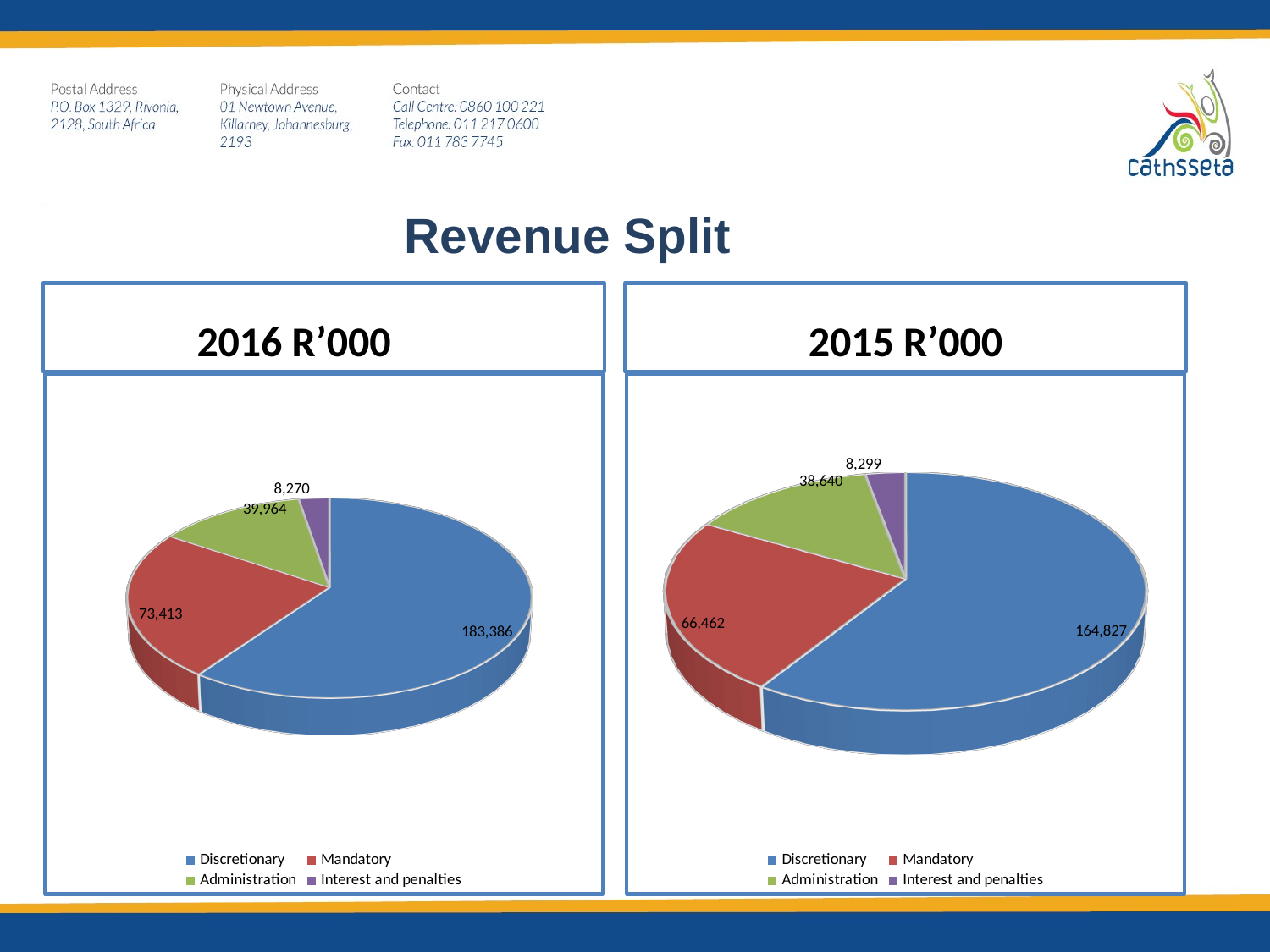
In the 2016 R'000 chart, what is the value for Administration? 39,964 In the 2016 R'000 chart, what is the difference between the Discretionary and Mandatory values? 109,973 What is the total of all slices in the 2015 R'000 chart? 278,228 Is the Discretionary value larger in the 2016 R'000 chart or the 2015 R'000 chart? 2016 R'000 In the 2016 R'000 chart, which category has the smallest slice? Interest and penalties What colour represents Mandatory in the 2016 R'000 chart? Red In the 2015 R'000 chart, what is the value for Mandatory? 66,462 What type of chart is used for the 2016 R'000 chart? Pie chart In the 2015 R'000 chart, what is the value for Interest and penalties? 8,299 In the 2015 R'000 chart, which category has the largest slice? Discretionary How many categories does the legend of the 2015 R'000 chart list? 4 In the 2016 R'000 chart, what is the value for Discretionary? 183,386